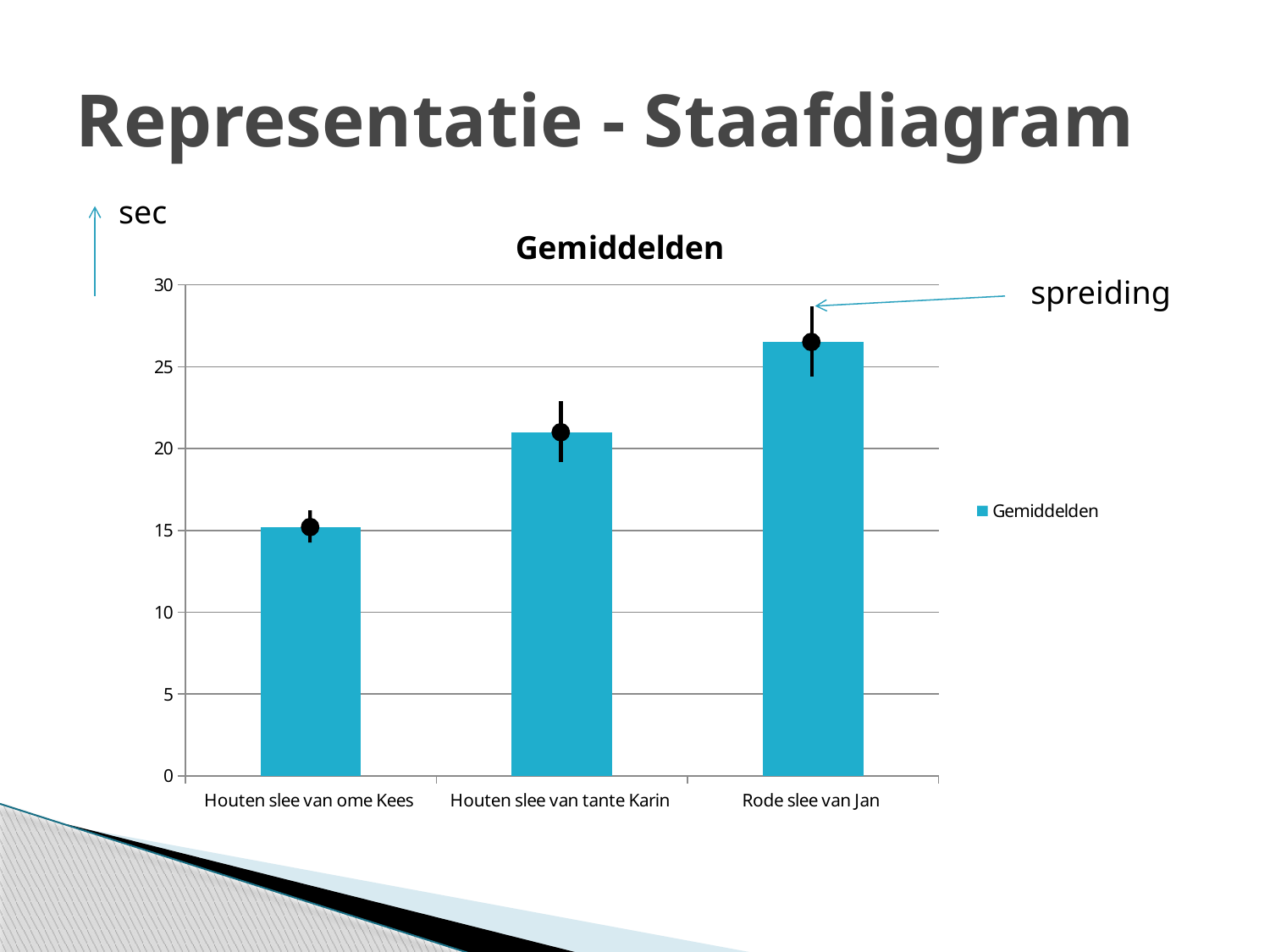
Is the value for Houten slee van tante Karin greater or less than 20? greater Which category has the lowest bar? Houten slee van ome Kees What kind of chart is shown on the slide? bar chart Which is larger, the value for Houten slee van tante Karin or the value for Houten slee van ome Kees? Houten slee van tante Karin Which category has the highest bar? Rode slee van Jan How many categories are shown on the x axis of the chart? 3 What unit is indicated for the vertical axis of the chart? sec Is the value for Houten slee van ome Kees greater or less than 20? less How many series does the legend list? 1 Do the bar values rise or fall from left to right along the x axis? rise Is the value for Rode slee van Jan greater or less than 25? greater What is the title of the chart? Gemiddelden